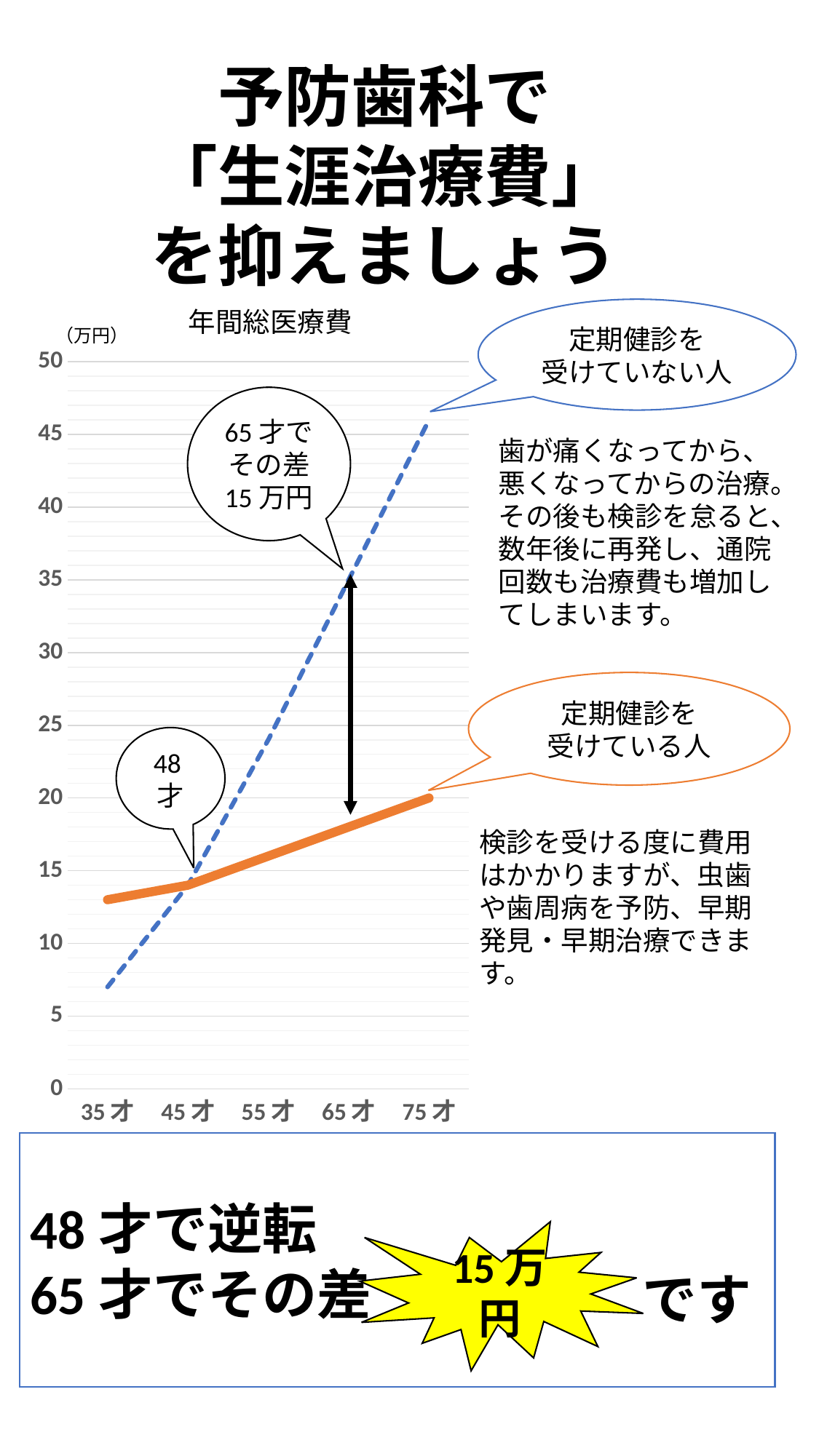
What is the title of the chart? 年間総医療費 According to the annotation, at what age do the two lines cross? 48才 How many age categories are labelled on the x axis? 5 According to the annotation, what is the difference between the two lines at 65才? 15万円 How many series (lines) are plotted on the chart? 2 What kind of chart is shown on the slide? line chart Do the values for 定期健診を受けていない人 rise or fall as age increases? rise Is the value for 定期健診を受けていない人 at 35才 greater or less than 10? less Is the value for 定期健診を受けていない人 at 65才 greater or less than 30? greater At 65才, which line is higher: 定期健診を受けていない人 or 定期健診を受けている人? 定期健診を受けていない人 What unit is shown on the y axis of the chart? 万円 Is the value for 定期健診を受けている人 at 35才 greater or less than 10? greater